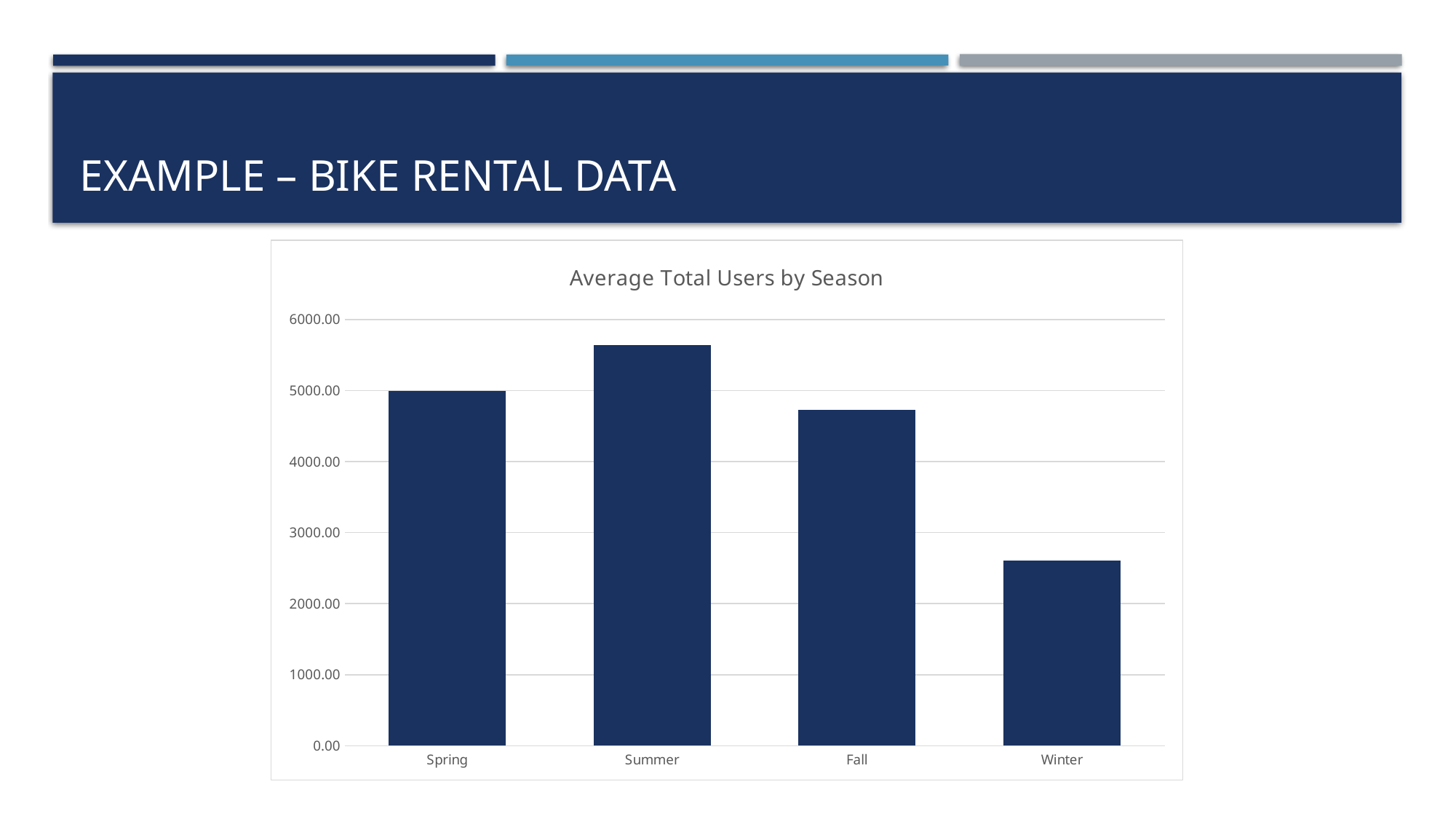
How many seasons are plotted on the chart? 4 Is the value for Winter greater or less than 3000.00? less Is the value for Fall greater or less than 5000.00? less Which has more average total users, Spring or Winter? Spring Which season has the lowest average total users? Winter What is the title of the chart? Average Total Users by Season Which has more average total users, Summer or Fall? Summer Is the value for Spring greater or less than 4000.00? greater What kind of chart is shown on the slide? bar chart Which season has the highest average total users? Summer Does the value rise or fall from Fall to Winter? fall